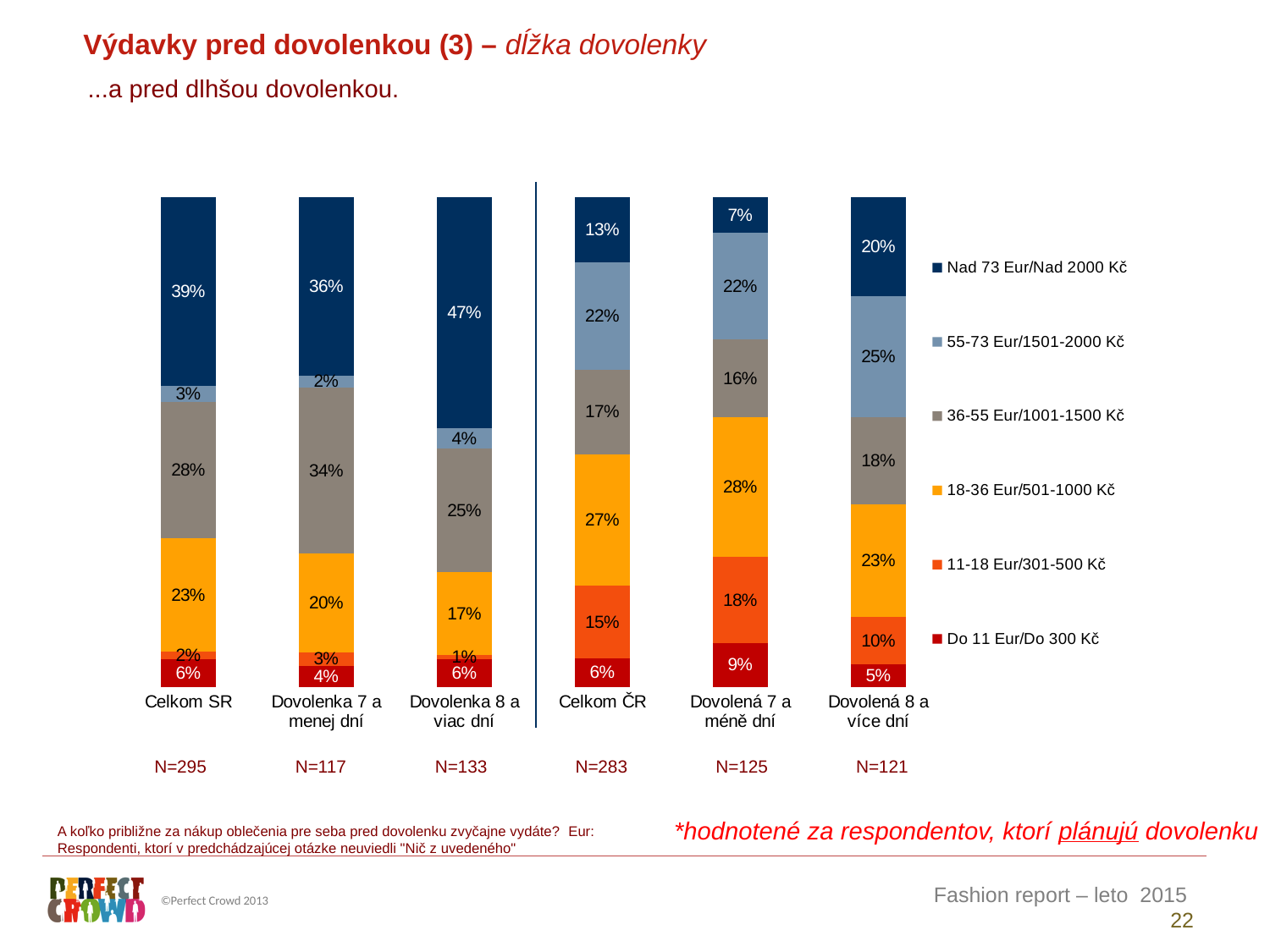
How many series does the legend list? 6 Which is larger: the '55-73 Eur/1501-2000 Kč' value for 'Celkom SR' or for 'Celkom ČR'? Celkom ČR What kind of chart is shown on the slide? Stacked bar chart Which colour represents the 'Do 11 Eur/Do 300 Kč' series in the legend? Dark red What is the value of the '18-36 Eur/501-1000 Kč' segment for 'Celkom ČR'? 27% Which category has the lowest value for the 'Do 11 Eur/Do 300 Kč' series? Dovolenka 7 a menej dní What is the difference between the '36-55 Eur/1001-1500 Kč' values for 'Dovolenka 7 a menej dní' and 'Dovolenka 8 a viac dní'? 9% What is the value of the '11-18 Eur/301-500 Kč' segment for 'Dovolená 7 a méně dní'? 18% What is the sample size (N) shown for 'Dovolená 8 a více dní'? N=121 What is the value of the 'Nad 73 Eur/Nad 2000 Kč' segment for 'Dovolenka 8 a viac dní'? 47% Which category has the highest value for the 'Nad 73 Eur/Nad 2000 Kč' series? Dovolenka 8 a viac dní How many categories are shown along the x axis? 6